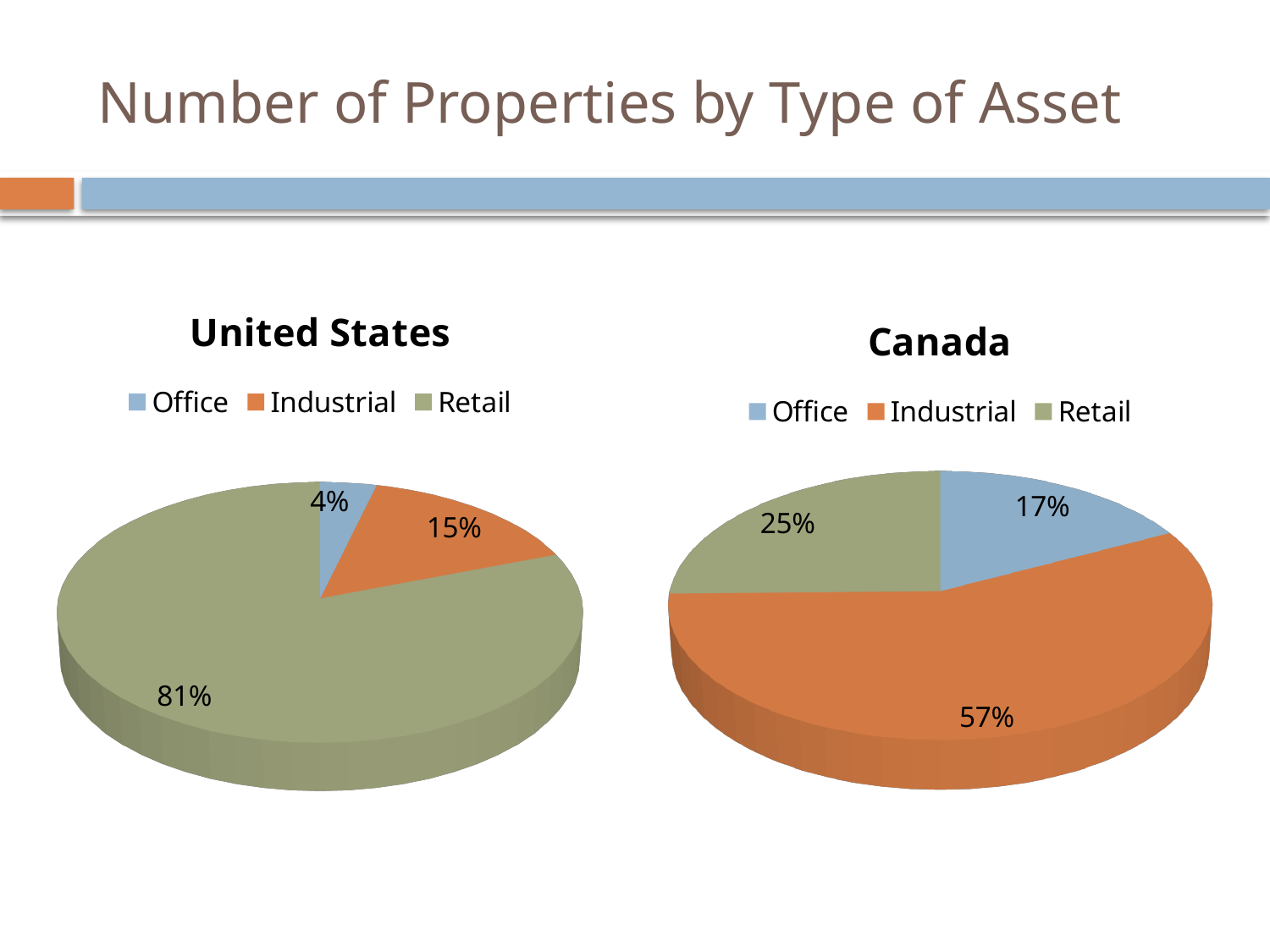
In the United States chart, what share of properties is Office? 4% In the United States chart, which asset type has the largest share? Retail How many slices does the Canada chart have? 3 In the Canada chart, which asset type has the smallest share? Office In the Canada chart, what share of properties is Industrial? 57% In the Canada chart, what is the difference between the Industrial and Retail shares? 32% What is the title of the slide? Number of Properties by Type of Asset In the Canada chart, what share of properties is Retail? 25% Which is larger: the Office share in the Canada chart or the Industrial share in the United States chart? Office share in Canada In the United States chart, what is the difference between the Industrial and Office shares? 11% What kind of chart is the United States chart? Pie chart